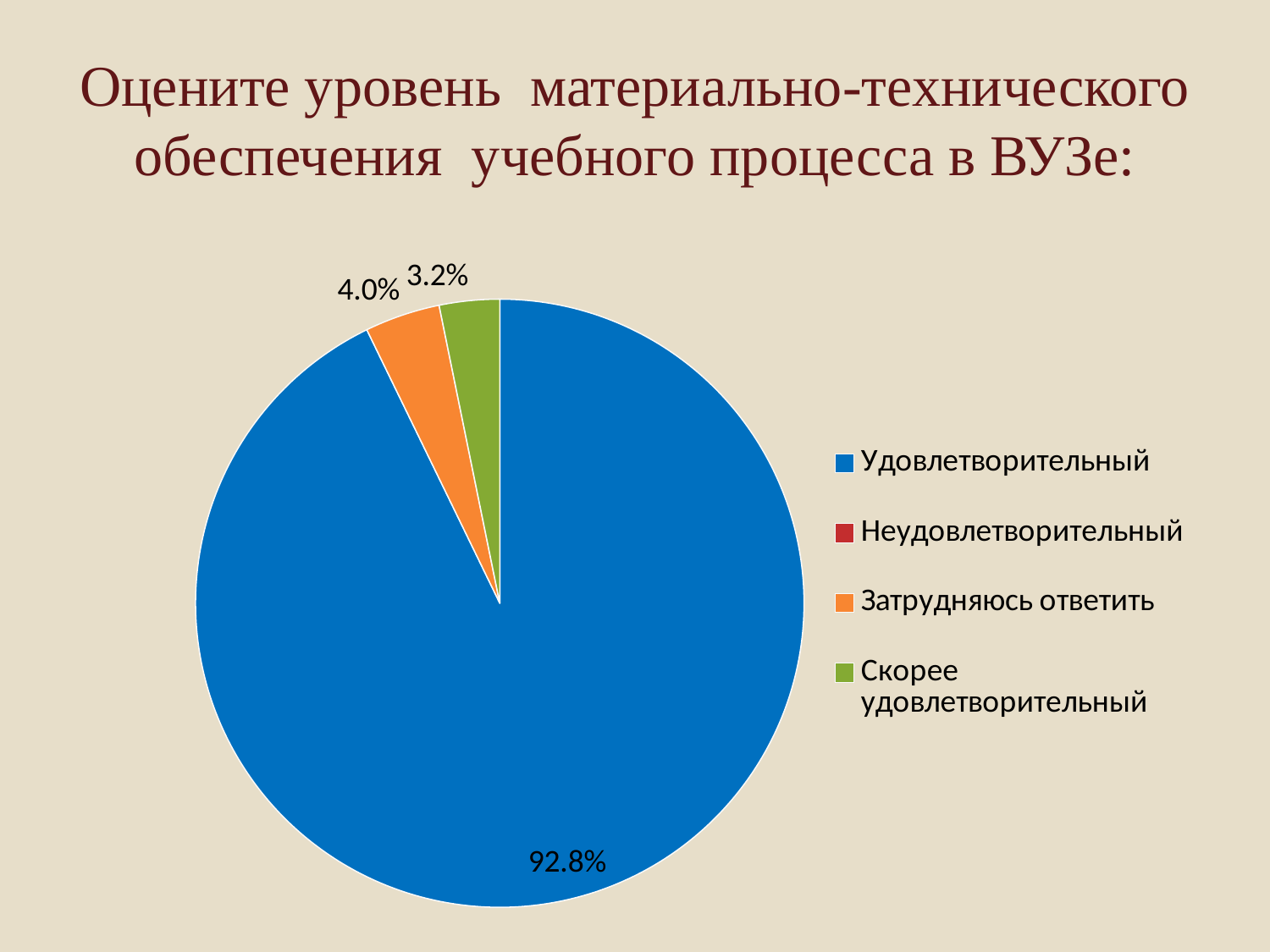
What share of the pie is labelled for Затрудняюсь ответить? 4.0% What is the difference in percentage points between the Удовлетворительный slice and the Затрудняюсь ответить slice? 88.8 What share of the pie is labelled for Скорее удовлетворительный? 3.2% Is the share for Удовлетворительный greater or less than 90%? greater Which is larger, the slice for Затрудняюсь ответить or the slice for Скорее удовлетворительный? Затрудняюсь ответить What share of the pie is labelled for Удовлетворительный? 92.8% How many categories does the legend list? 4 What colour is the slice for Удовлетворительный? blue What is the difference in percentage points between the Затрудняюсь ответить slice and the Скорее удовлетворительный slice? 0.8 Which category has the largest slice of the pie? Удовлетворительный Which legend entry is shown in orange? Затрудняюсь ответить What kind of chart is shown on the slide? pie chart